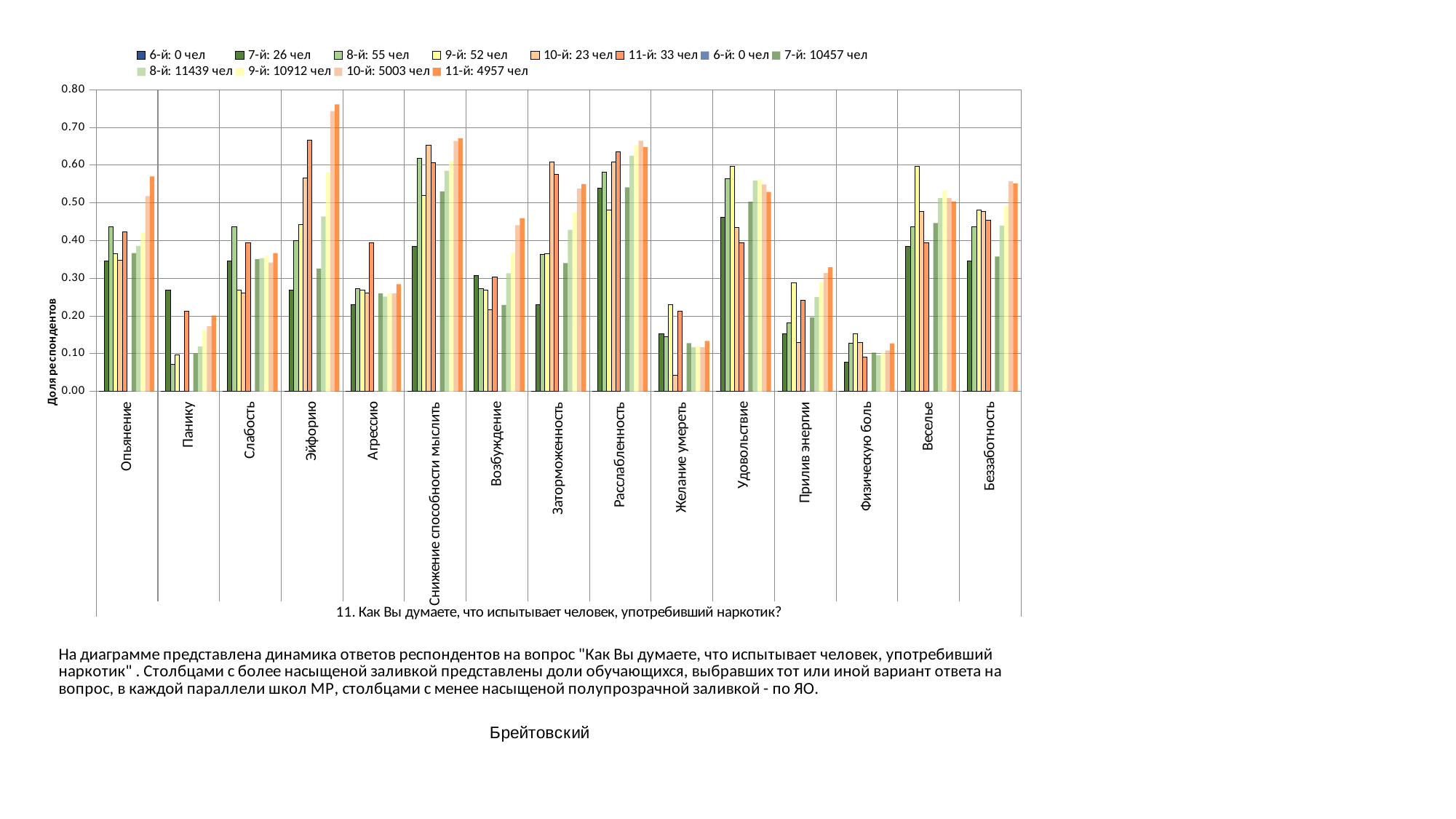
Is the value of the series "11-й: 4957 чел" for Эйфорию greater or less than 0.70? greater What is the title of the chart's vertical axis? Доля респондентов Is the value of the series "7-й: 26 чел" for Панику greater or less than 0.20? greater For the series "11-й: 4957 чел", which category has the highest value? Эйфорию What kind of chart is shown on the slide? bar chart For the series "11-й: 4957 чел", which is larger: the value for Эйфорию or the value for Физическую боль? Эйфорию How many series does the chart legend list? 12 Is the value of the series "10-й: 23 чел" for Желание умереть greater or less than 0.10? less What is the title shown beneath the chart? 11. Как Вы думаете, что испытывает человек, употребивший наркотик? How many categories are shown along the x axis of the chart? 15